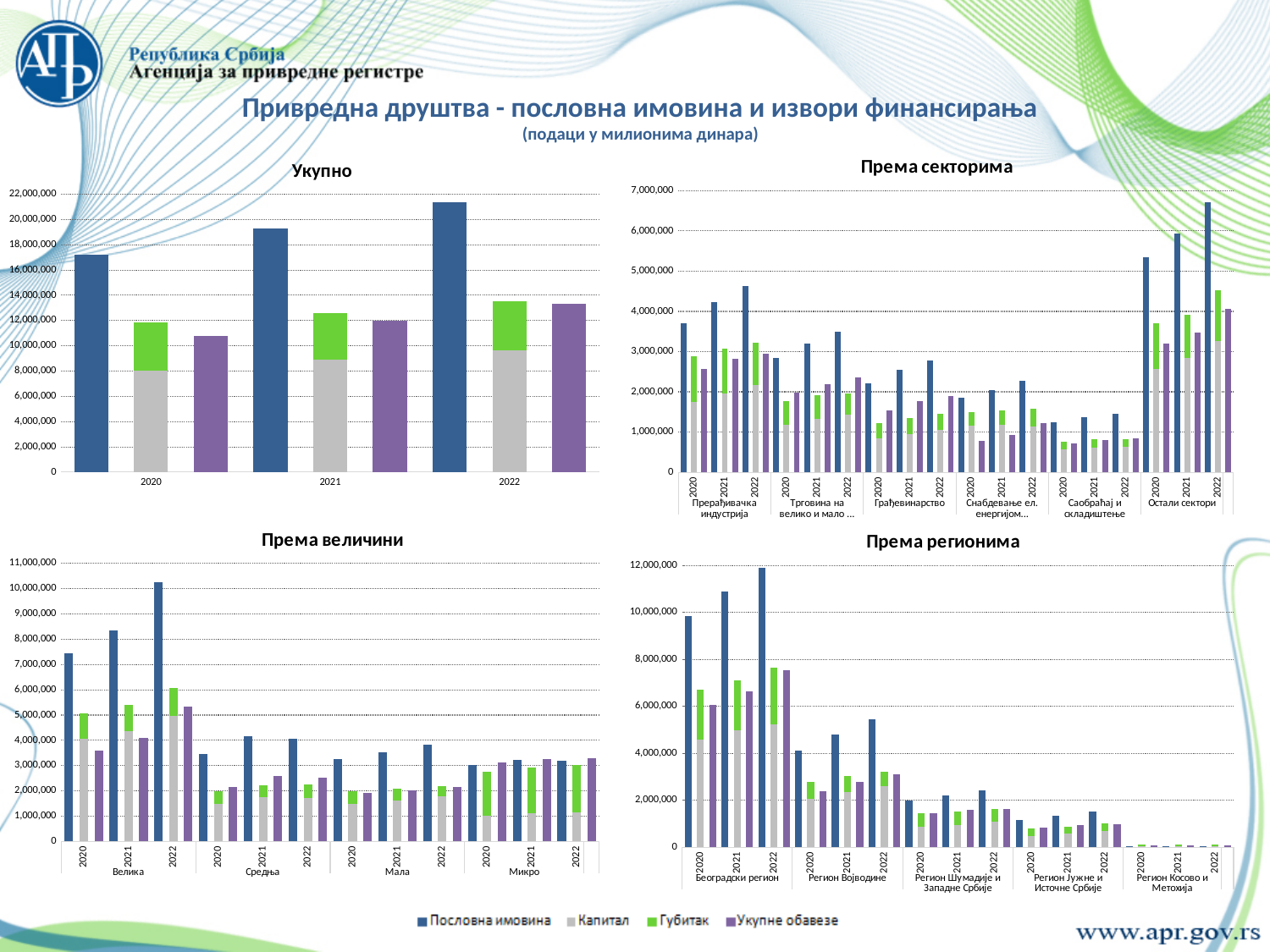
In the "Према регионима" chart, which region has the lowest bars overall? Регион Косово и Метохија What kind of chart is the "Укупно" chart? bar chart In the "Укупно" chart, is the value of Укупне обавезе for 2020 greater or less than 12,000,000? less How many series does the legend at the bottom of the slide list? 4 In the "Према секторима" chart, how many sectors are shown on the x axis? 6 In the "Укупно" chart, is the value of Пословна имовина for 2022 greater or less than 20,000,000? greater In the "Према секторима" chart, which sector has the highest Пословна имовина bar in 2022? Остали сектори In the "Према величини" chart, which size category has the highest Пословна имовина bar? Велика In the "Према регионима" chart, which is larger in 2021: Пословна имовина for Београдски регион or for Регион Војводине? Београдски регион In the "Према секторима" chart, is the Пословна имовина value for Прерађивачка индустрија in 2022 greater or less than 4,000,000? greater In the "Укупно" chart, how many years are shown on the x axis? 3 In the "Укупно" chart, does the value of Пословна имовина rise or fall from 2020 to 2022? rise